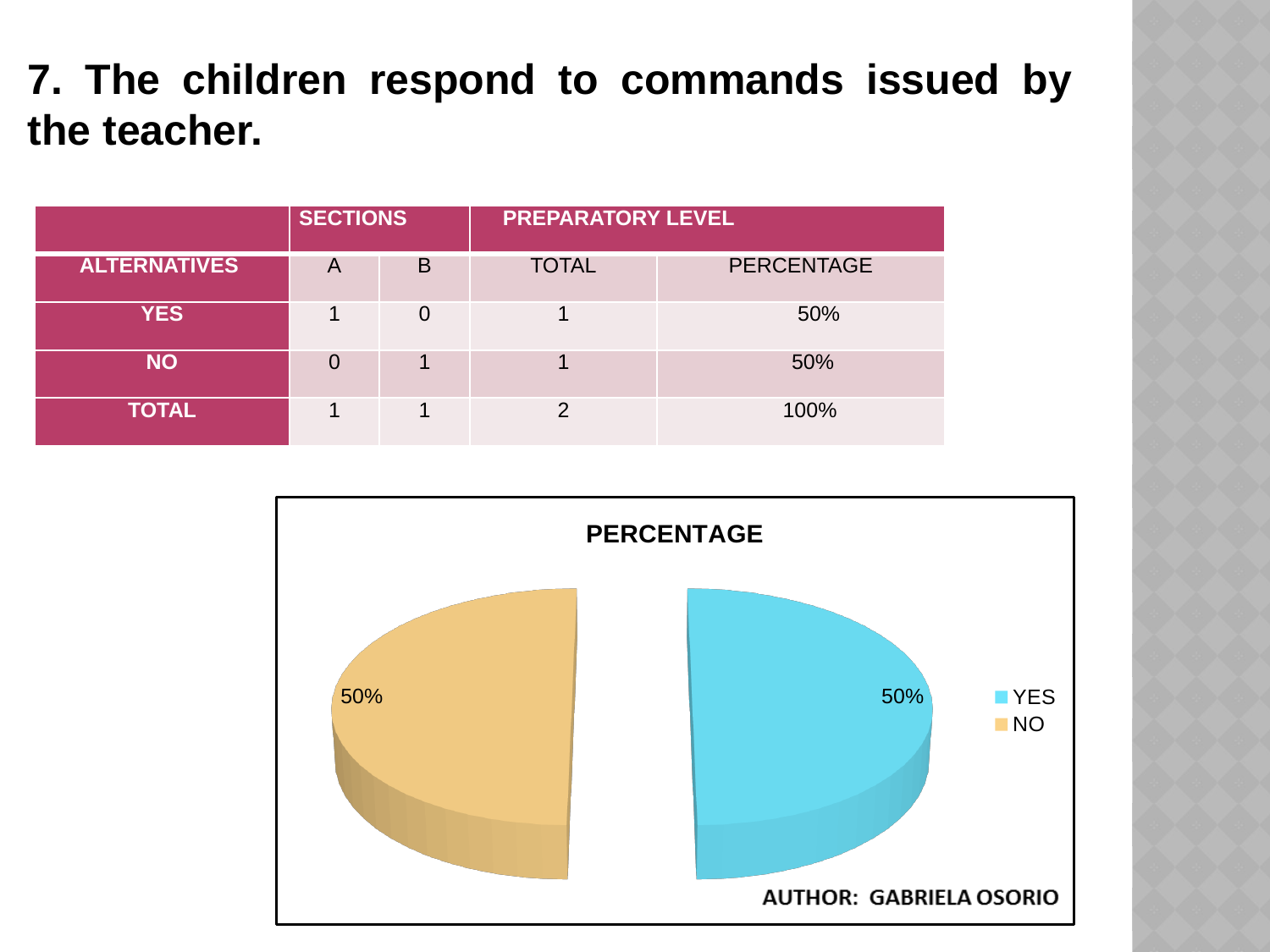
Which colour represents the YES slice? blue Is the value for YES greater or less than 40%? greater What share of the pie does the NO slice represent? 50% What kind of chart is shown on the slide? pie chart What is the chart's title? PERCENTAGE What is the total of the YES and NO shares? 100% What share of the pie does the YES slice represent? 50% How many entries does the legend list? 2 How many slices does the pie chart have? 2 What is the difference between the YES and NO shares? 0% Is the value for NO greater or less than 60%? less